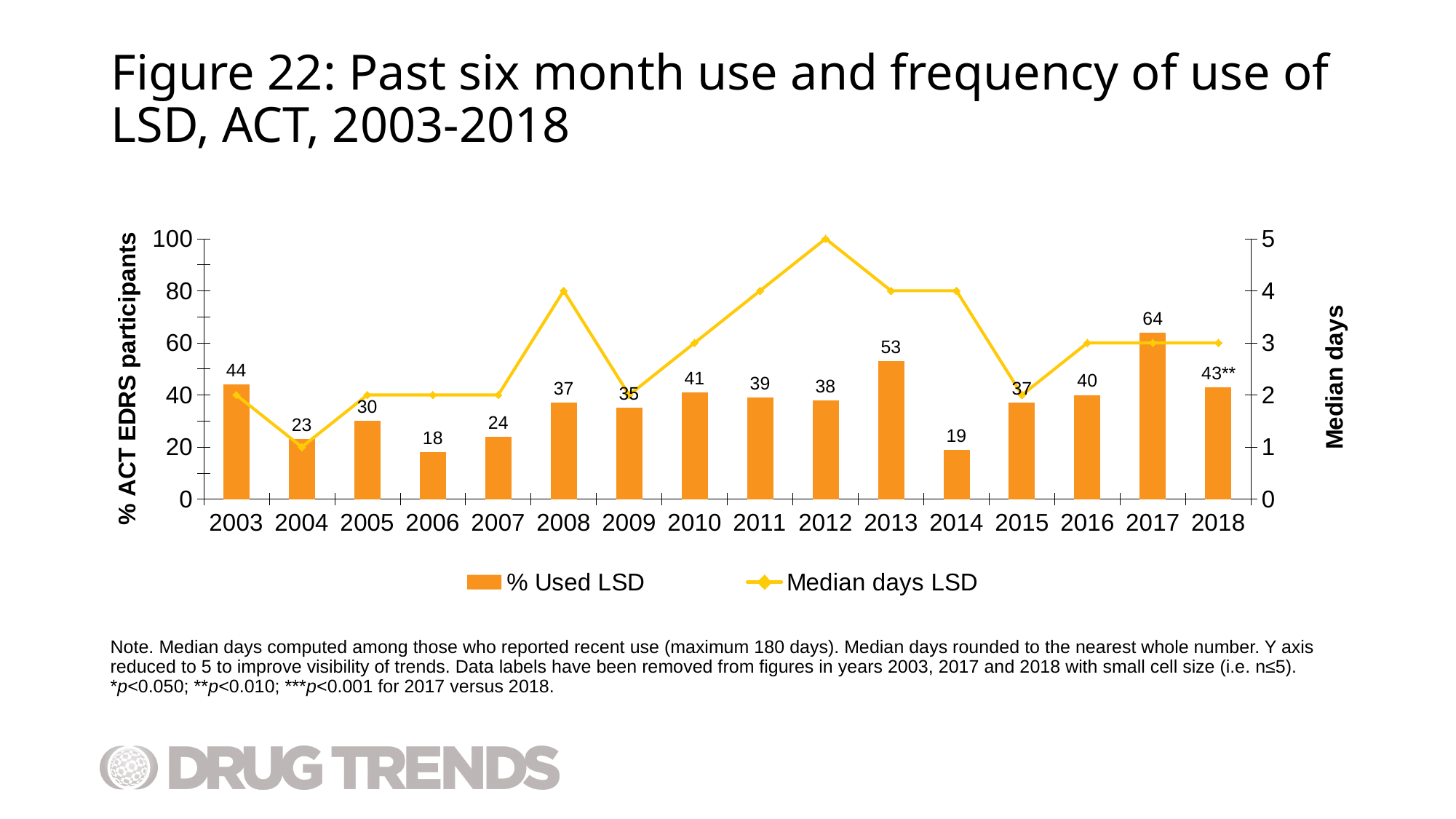
Which year has the highest % Used LSD bar? 2017 What percentage of ACT EDRS participants used LSD in 2013? 53 In which year does the Median days LSD line reach its highest point? 2012 What is the difference between the % Used LSD values for 2017 and 2013? 11 Which is larger, the % Used LSD value for 2010 or for 2011? 2010 What is the Median days LSD value for 2004, read from the right-hand axis? 1 What is the value of the % Used LSD bar for 2006? 18 Which year has the lowest % Used LSD bar? 2006 What is the data label shown on the % Used LSD bar for 2018? 43** How many series does the legend list? 2 How many years are shown on the x axis? 16 What is the label of the right-hand y axis? Median days